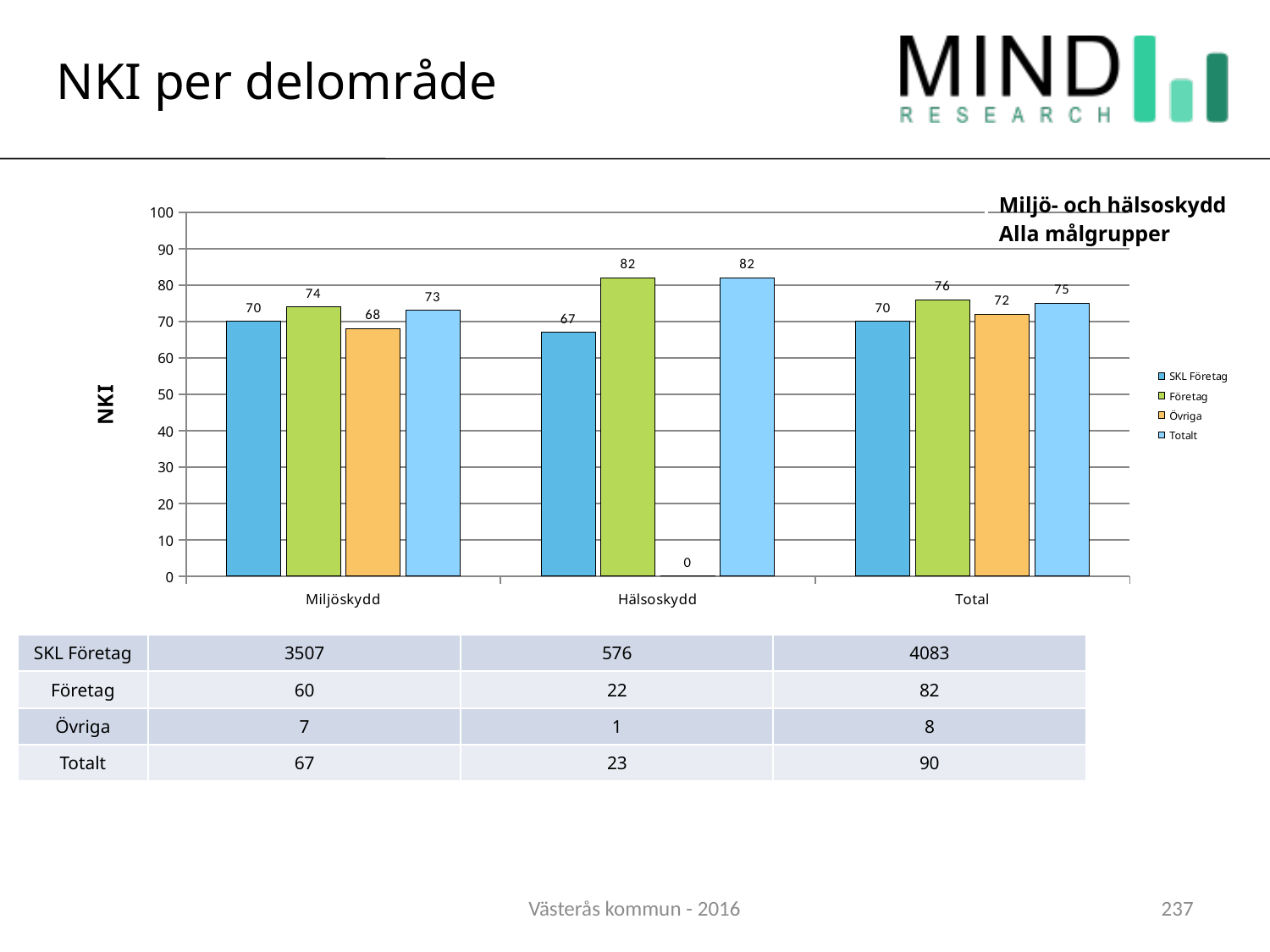
What is the NKI value for SKL Företag in the Miljöskydd category? 70 What kind of chart is shown on the slide? bar chart Which series has the lowest value in the Hälsoskydd category? Övriga What is the label on the vertical axis of the chart? NKI How many series does the legend list? 4 Which is larger: the Totalt value for Hälsoskydd or the Totalt value for Miljöskydd? Hälsoskydd Is the value for Företag in Hälsoskydd greater or less than 80? greater How many categories are shown on the x axis? 3 What is the NKI value for Övriga in the Total category? 72 What is the difference between the Företag and SKL Företag values in the Total category? 6 What is the NKI value for Företag in the Hälsoskydd category? 82 Which series has the highest value in the Miljöskydd category? Företag